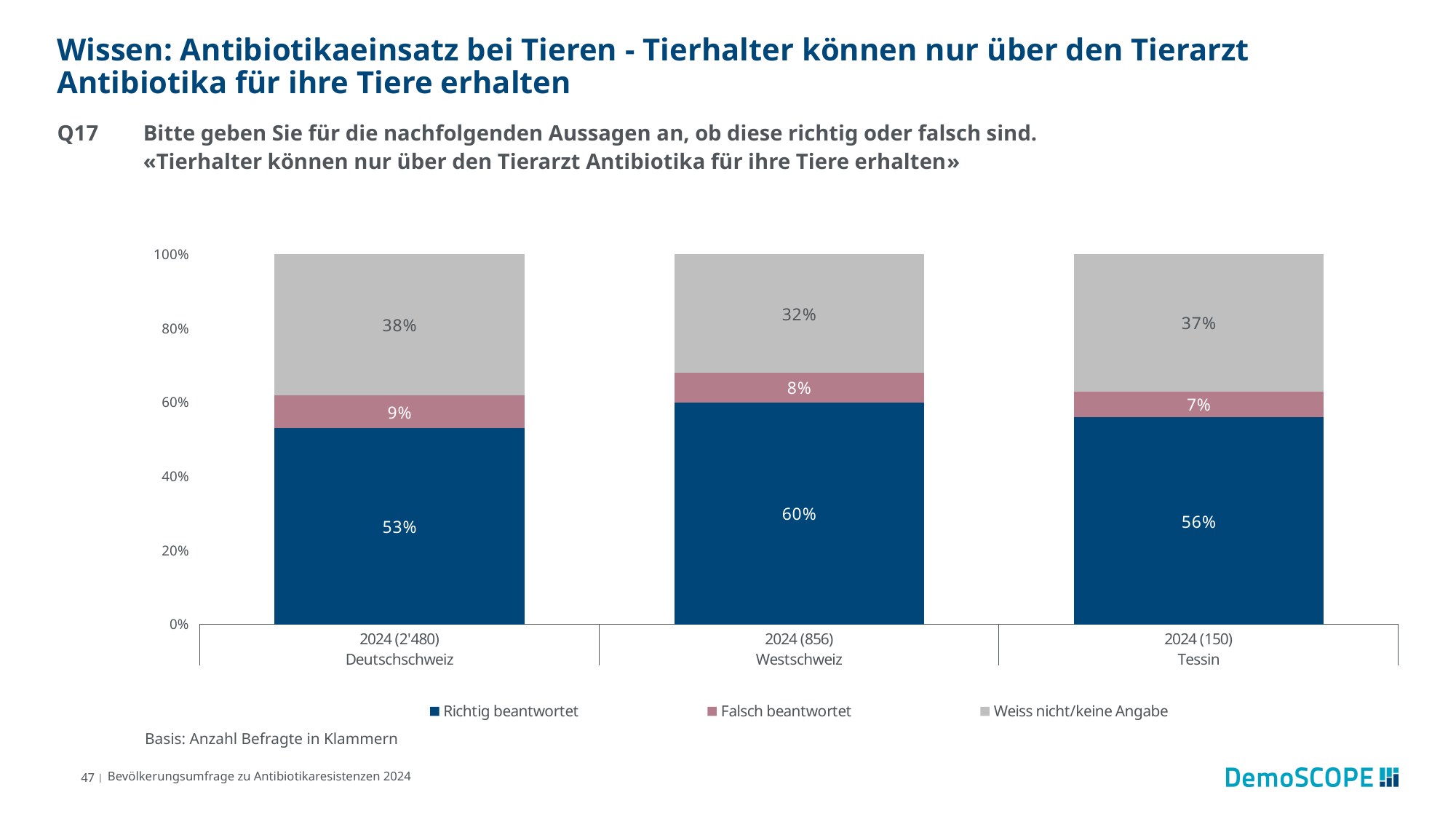
Is the 'Falsch beantwortet' share larger in Deutschschweiz or in Tessin? Deutschschweiz What kind of chart is shown on the slide? Stacked bar chart How many respondents form the basis for the Westschweiz bar? 856 What is the difference in 'Richtig beantwortet' between Westschweiz and Deutschschweiz? 7 percentage points What is the total of the stacked bar for Tessin? 100% Which region has the highest share of 'Richtig beantwortet'? Westschweiz How many regions (bars) are shown in the chart? 3 What is the 'Weiss nicht/keine Angabe' share for Westschweiz? 32% Which region has the lowest share of 'Weiss nicht/keine Angabe'? Westschweiz How many series does the legend list? 3 What percentage of respondents in Deutschschweiz answered correctly (Richtig beantwortet)? 53% What percentage of respondents in Tessin answered incorrectly (Falsch beantwortet)? 7%